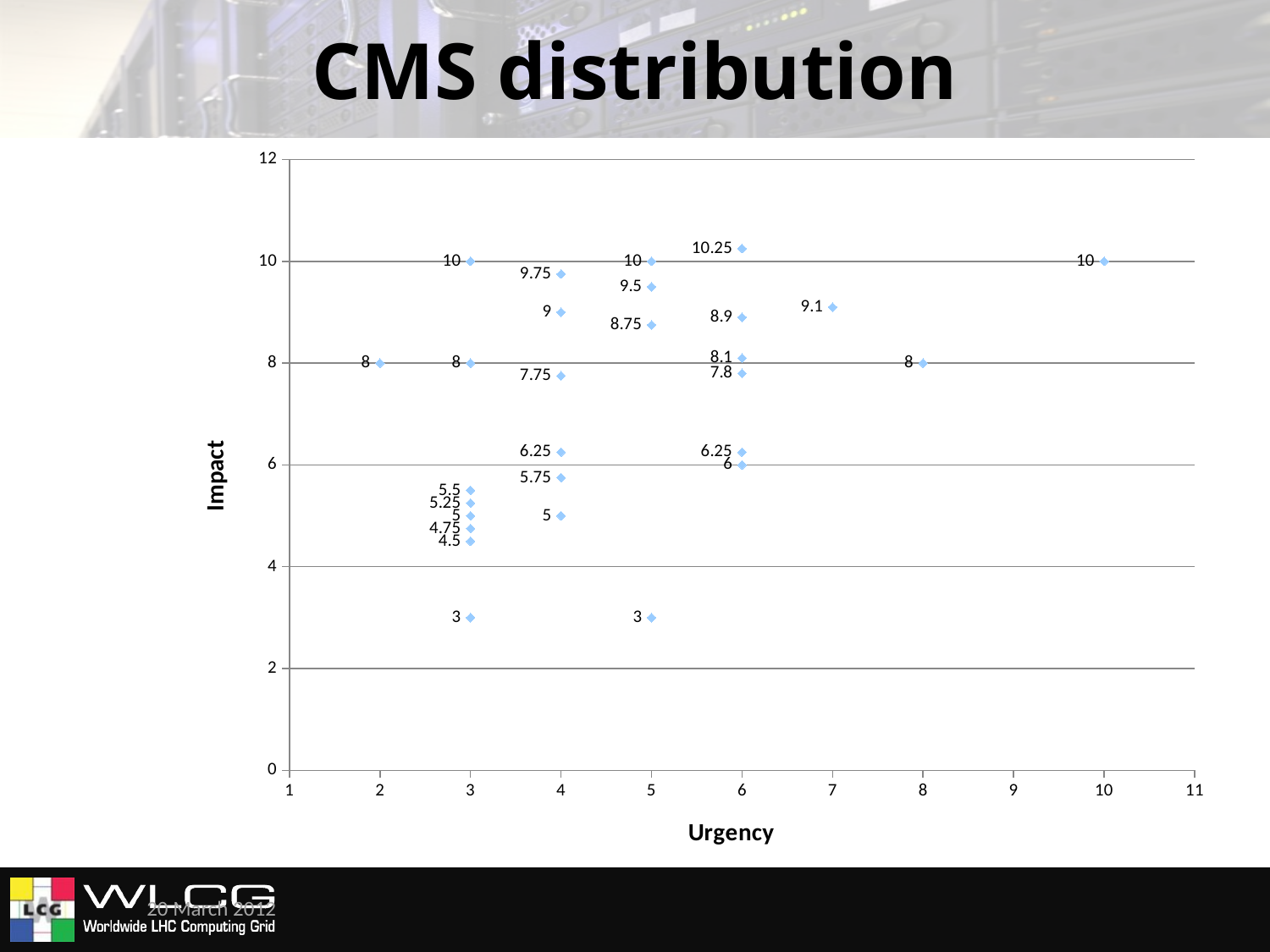
What is the lowest Impact value plotted on the chart? 3 Which has the higher Impact value: the point at Urgency 7 or the point at Urgency 8? Urgency 7 What is the title of the chart? CMS distribution What is the highest Impact value plotted on the chart? 10.25 What is the difference between the highest Impact value (at Urgency 6) and the Impact value at Urgency 7? 1.15 What are the labels of the x axis and y axis? Urgency (x axis) and Impact (y axis) Is the Impact value of the point at Urgency 7 greater or less than 8? greater What is the Impact value of the point at Urgency 10? 10 What kind of chart is shown on the slide? scatter chart How many points are plotted at Urgency 3? 8 What is the Impact value of the point at Urgency 7? 9.1 What is the Impact value of the point at Urgency 2? 8